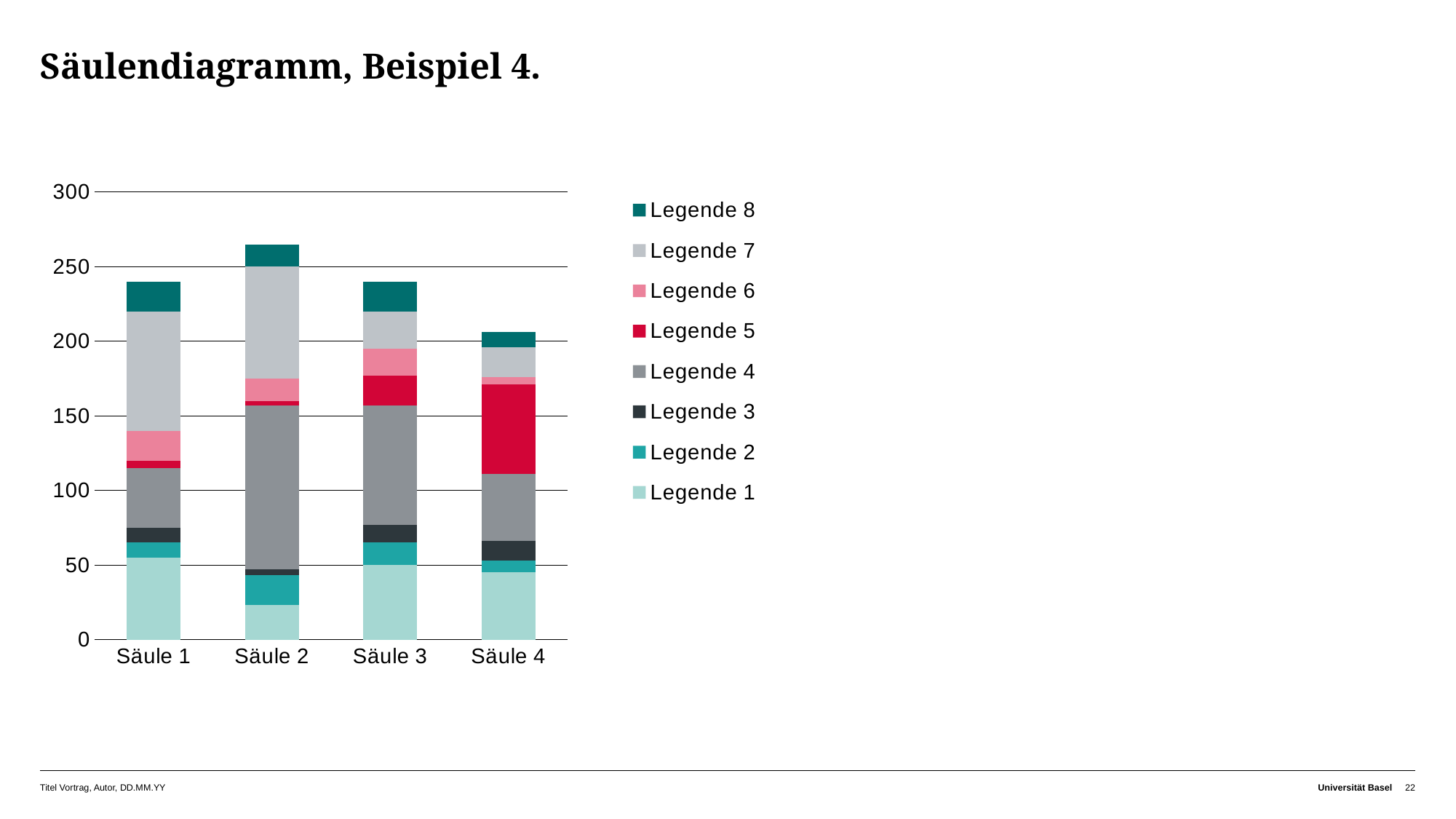
What is the title of the slide? Säulendiagramm, Beispiel 4. Is the total for Säule 2 larger or smaller than the total for Säule 4? larger Which category has the lowest total stacked value? Säule 4 Which category has the largest Legende 5 segment? Säule 4 Is the total value for Säule 1 greater or less than 200? greater Which category has the smallest Legende 1 segment? Säule 2 Which category has the highest total stacked value? Säule 2 How many categories are shown on the x axis? 4 Is the total value for Säule 4 greater or less than 250? less How many series does the legend list? 8 Is the total value for Säule 2 greater or less than 250? greater What kind of chart is shown on the slide? Stacked bar chart